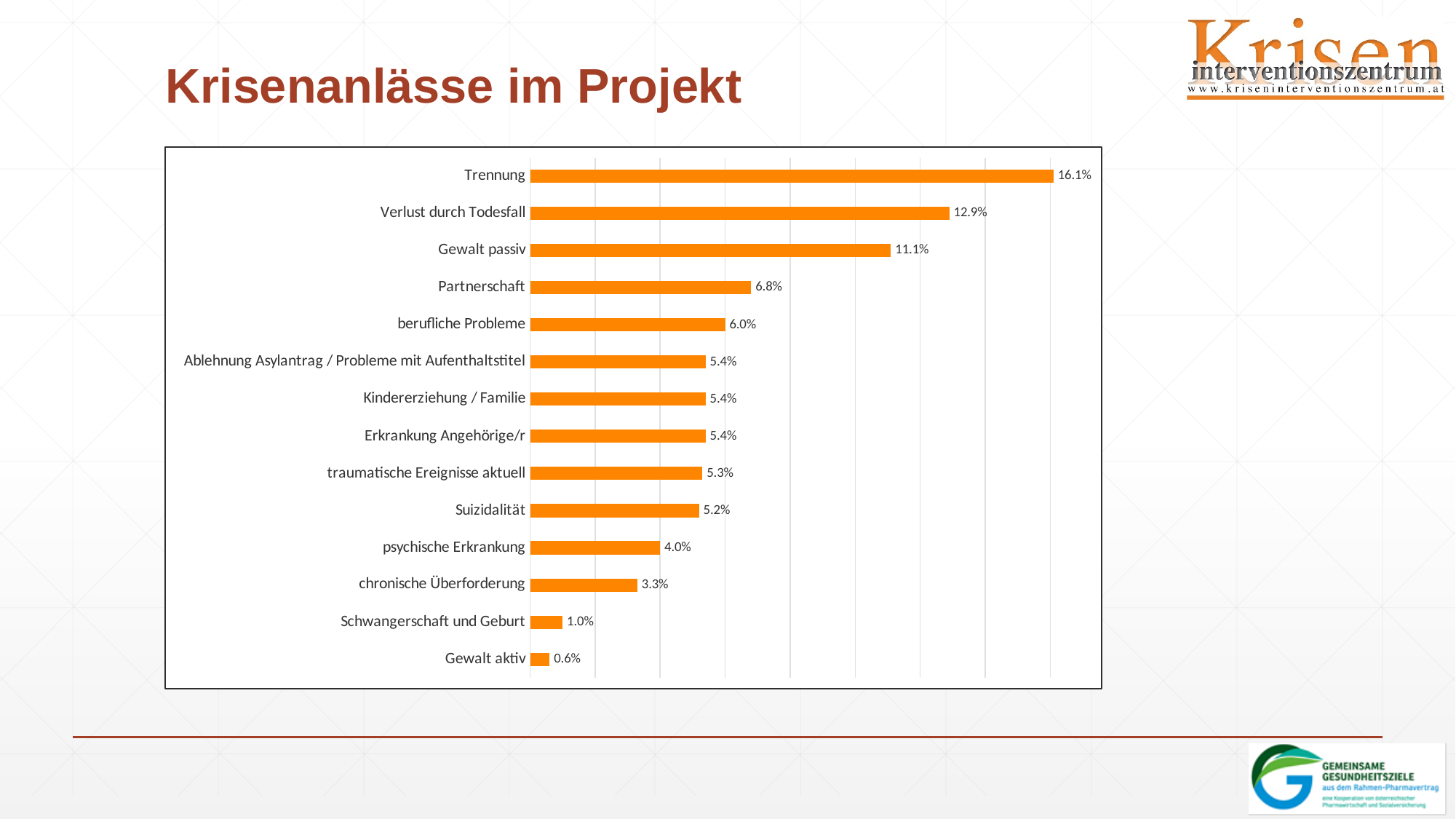
What is the difference between the values for Trennung and Verlust durch Todesfall? 3.2% Which is larger, the value for psychische Erkrankung or the value for chronische Überforderung? psychische Erkrankung Which category has the highest value? Trennung What kind of chart is shown on the slide? bar chart What is the value for Schwangerschaft und Geburt? 1.0% What is the title of the slide containing the chart? Krisenanlässe im Projekt What is the difference between the values for Partnerschaft and berufliche Probleme? 0.8% How many categories are shown in the chart? 14 What is the value for Suizidalität? 5.2% Which category has the lowest value? Gewalt aktiv What is the value for Gewalt passiv? 11.1% What is the value for Trennung? 16.1%